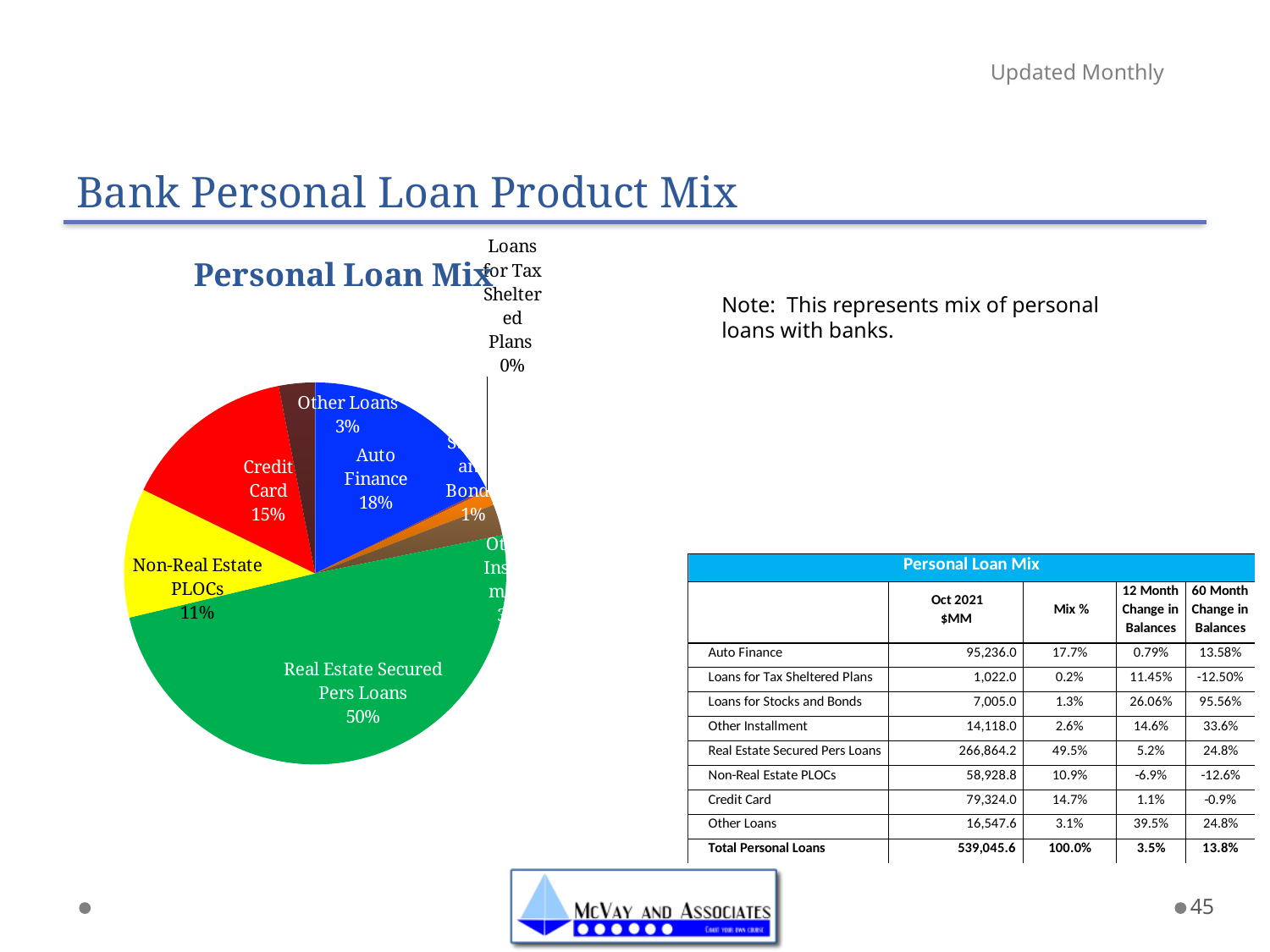
Which slice is larger, Credit Card or Auto Finance? Auto Finance What kind of chart is shown on the slide? pie chart What percentage is shown for Other Loans? 3% What share of the pie is Real Estate Secured Pers Loans? 50% What colour is the Real Estate Secured Pers Loans slice? green What percentage is shown for Loans for Tax Sheltered Plans? 0% What percentage does the Credit Card slice show? 15% What percentage does the Auto Finance slice show? 18% What share of the pie is Non-Real Estate PLOCs? 11% How many percentage points larger is the Real Estate Secured Pers Loans slice than the Auto Finance slice? 32 What is the title of the chart? Personal Loan Mix Which category has the largest slice of the pie? Real Estate Secured Pers Loans